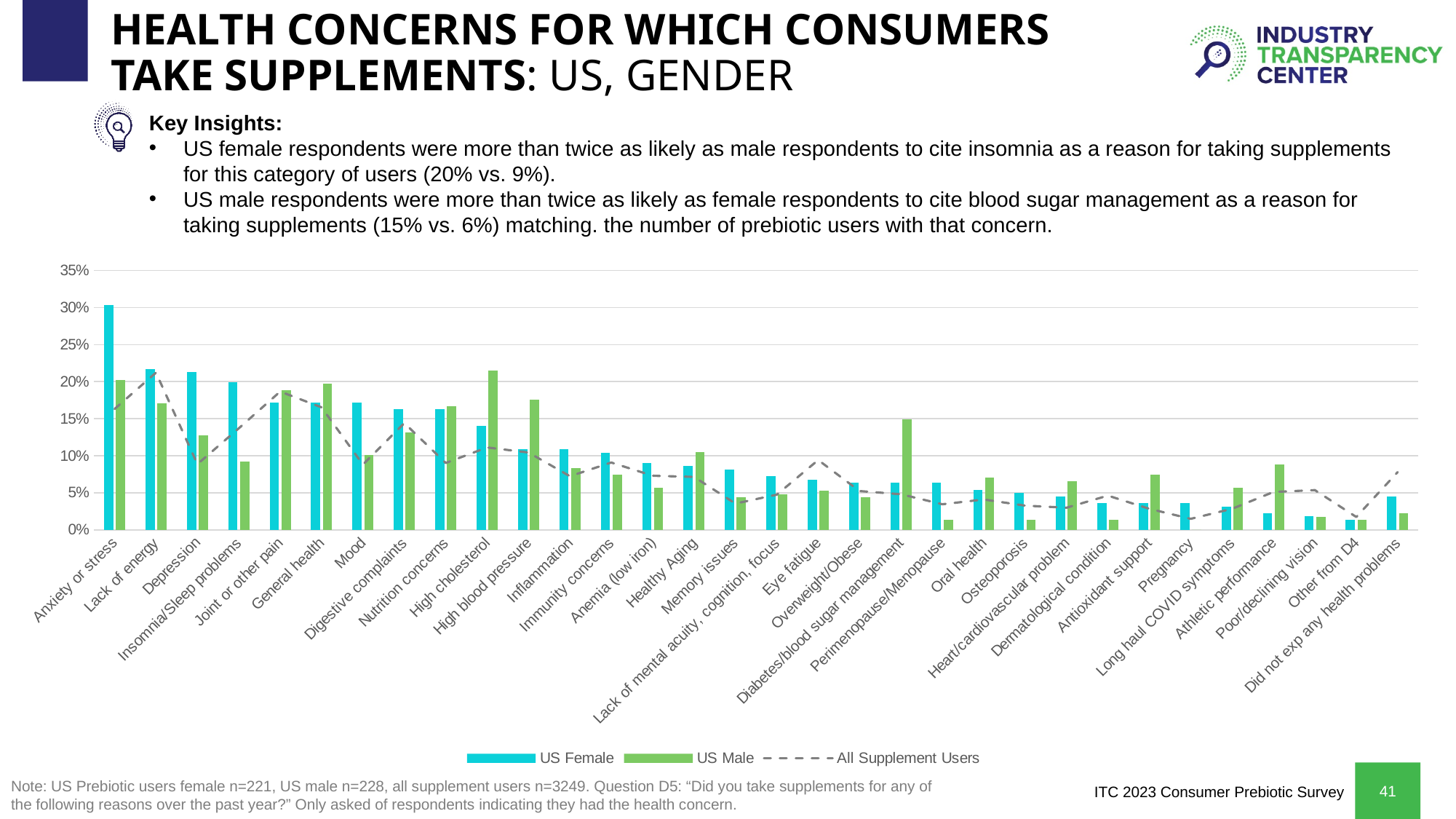
For Anxiety or stress, which is larger: the US Female value or the US Male value? US Female What kind of chart is shown on the slide? Combination bar and line chart Which series is drawn as a dashed grey line in the chart? All Supplement Users For High cholesterol, which is larger: the US Female value or the US Male value? US Male How many health concern categories are shown along the x axis? 32 Which health concern has the highest US Female value? Anxiety or stress Is the US Female value for Insomnia/Sleep problems greater or less than 15%? greater How many series does the chart's legend list? 3 Is the US Male value for Perimenopause/Menopause greater or less than 5%? less Is the US Male value for Diabetes/blood sugar management greater or less than 10%? greater Which health concern has the highest US Male value? High cholesterol